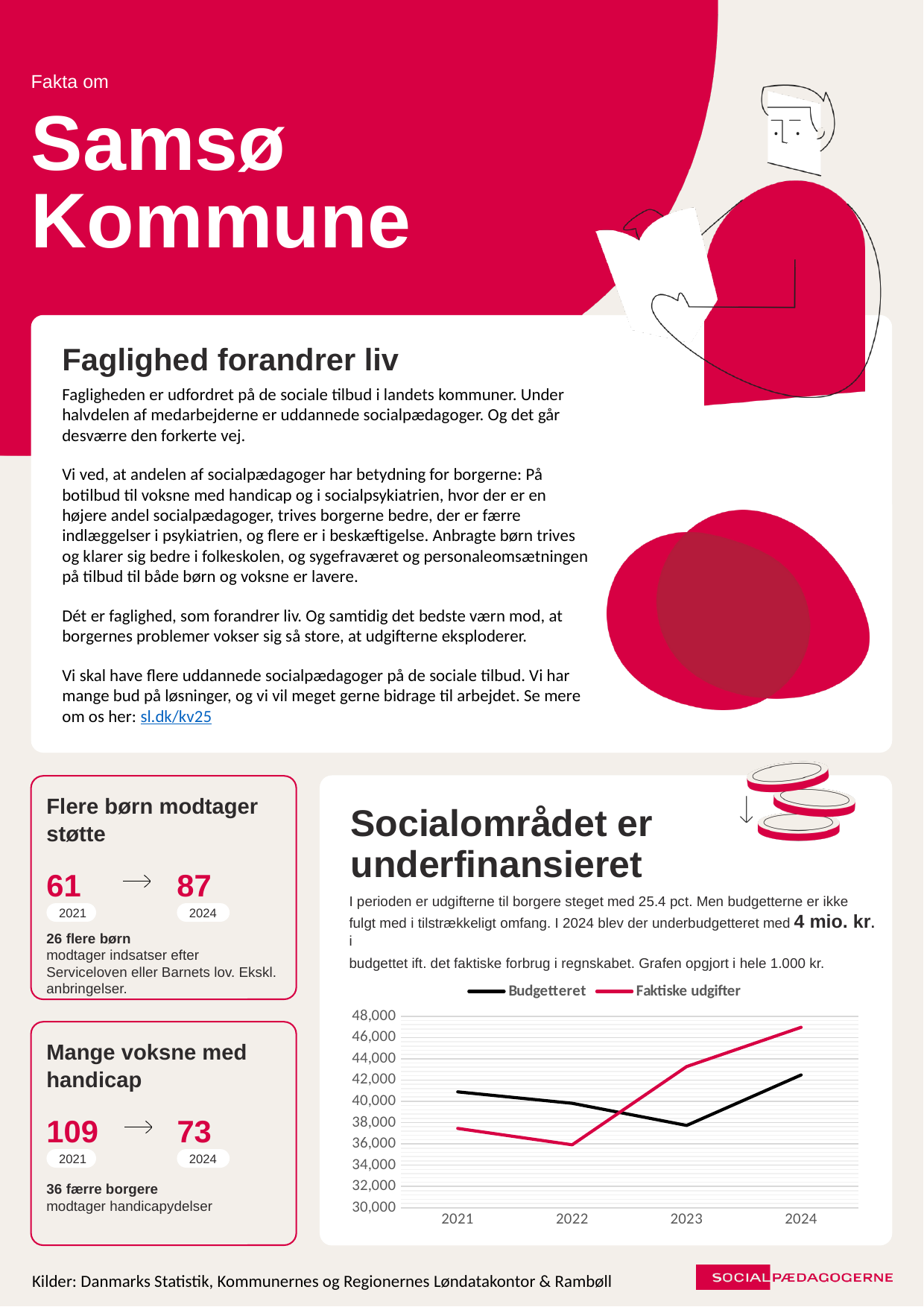
Do the values for Faktiske udgifter rise or fall from 2022 to 2024? rise Is the value for Faktiske udgifter in 2024 greater or less than 46,000? greater How many series does the legend of the line chart list? 2 In the line chart, which series has the larger value in 2024, Budgetteret or Faktiske udgifter? Faktiske udgifter In the line chart, which year has the highest value for Faktiske udgifter? 2024 In the line chart, which year has the lowest value for Budgetteret? 2023 What colour is the Faktiske udgifter line in the chart? Red Is the value for Budgetteret in 2023 greater or less than 40,000? less In the line chart, which year has the lowest value for Faktiske udgifter? 2022 In the line chart, which series has the larger value in 2021, Budgetteret or Faktiske udgifter? Budgetteret What kind of chart is shown under the heading "Socialområdet er underfinansieret"? Line chart How many years are plotted along the x axis of the line chart? 4